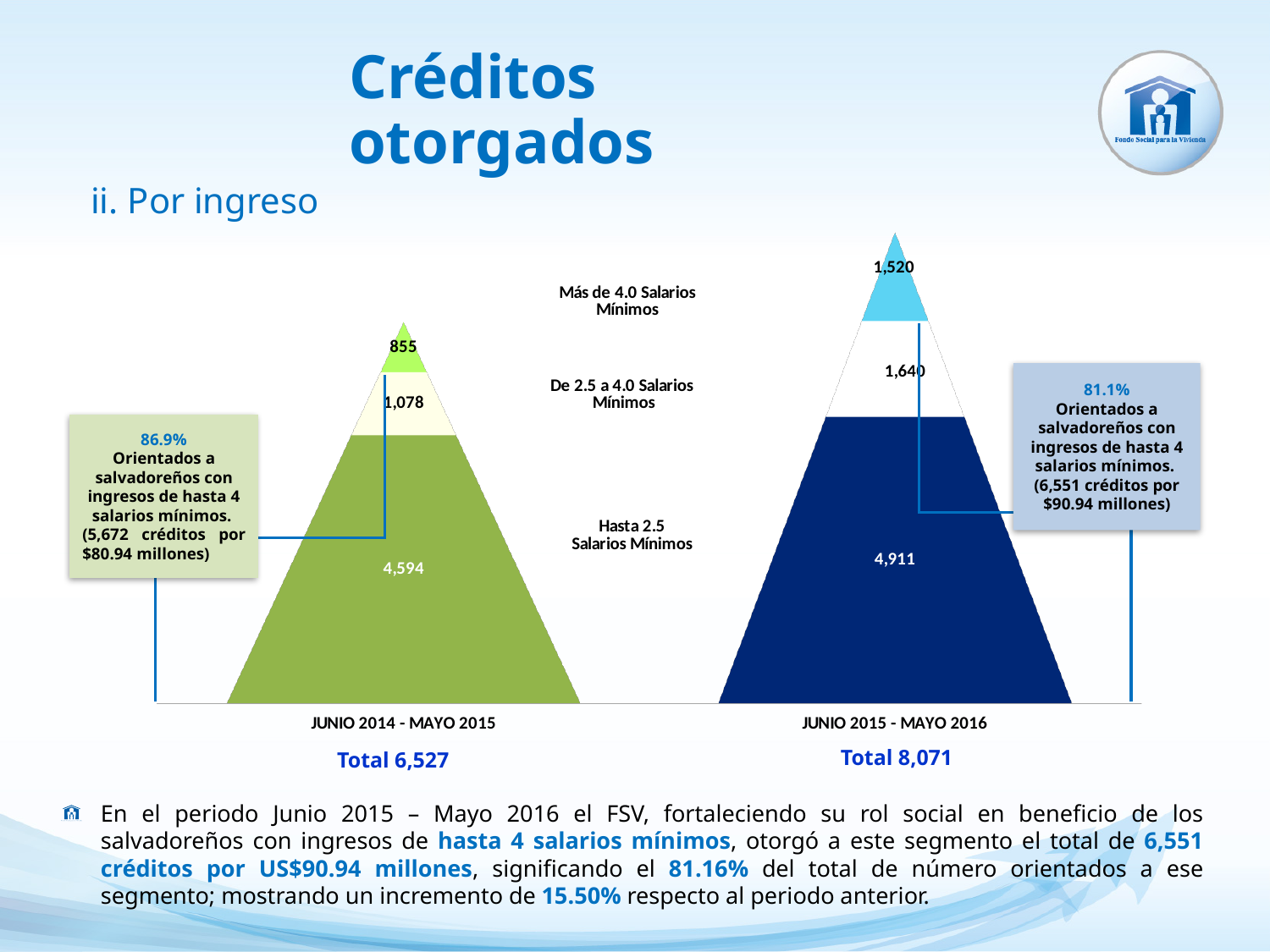
What is the value for 'De 2.5 a 4.0 Salarios Mínimos' in the JUNIO 2015 - MAYO 2016 period? 1,640 What is the total shown for the JUNIO 2015 - MAYO 2016 period? Total 8,071 What is the value for 'Más de 4.0 Salarios Mínimos' in the JUNIO 2014 - MAYO 2015 period? 855 What percentage of credits in the JUNIO 2015 - MAYO 2016 period went to Salvadorans with incomes up to 4 minimum salaries, according to the callout? 81.1% How many periods are compared in the chart? 2 Which income segment has the lowest value in the JUNIO 2014 - MAYO 2015 period? Más de 4.0 Salarios Mínimos What is the value for 'Hasta 2.5 Salarios Mínimos' in the JUNIO 2015 - MAYO 2016 period? 4,911 What is the total shown for the JUNIO 2014 - MAYO 2015 period? Total 6,527 Which period has the larger value for 'Más de 4.0 Salarios Mínimos'? JUNIO 2015 - MAYO 2016 Which income segment has the highest value in the JUNIO 2015 - MAYO 2016 period? Hasta 2.5 Salarios Mínimos How many income segments does each pyramid show? 3 What is the difference between the 'Hasta 2.5 Salarios Mínimos' values of the two periods? 317